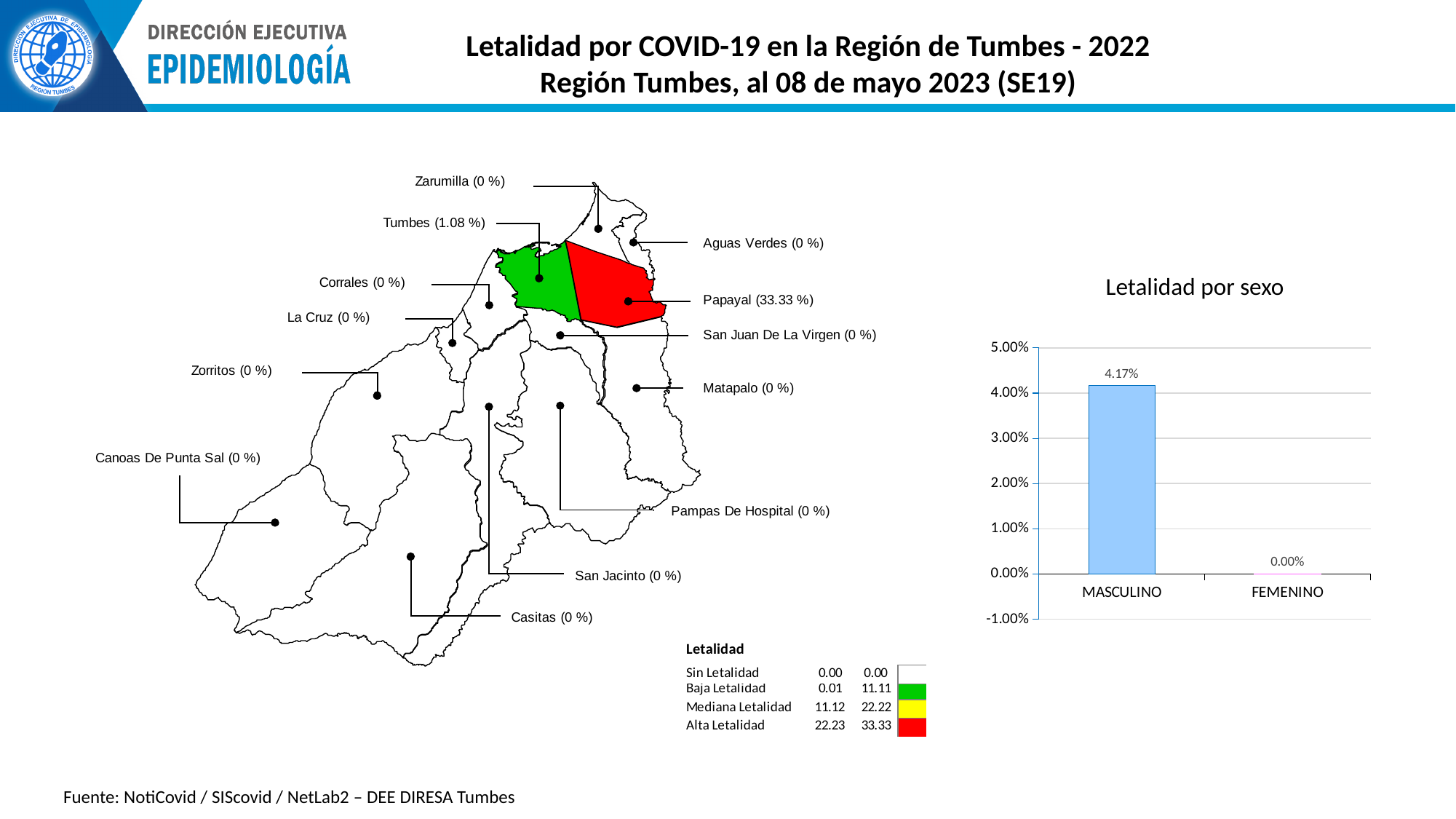
In the 'Letalidad por sexo' chart, what is the difference between the MASCULINO and FEMENINO values? 4.17% On the map of the Tumbes region, what is the lethality value shown for Tumbes? 1.08 % In the 'Letalidad por sexo' chart, which category has the lowest value? FEMENINO In the 'Letalidad por sexo' chart, what is the value for MASCULINO? 4.17% In the 'Letalidad por sexo' chart, which category has the highest value? MASCULINO What is the title of the chart on the right side of the slide? Letalidad por sexo In the 'Letalidad por sexo' chart, is the value for MASCULINO greater or less than 4.00%? greater On the map of the Tumbes region, which district has the highest lethality value? Papayal What kind of chart is 'Letalidad por sexo'? bar chart On the map of the Tumbes region, what is the lethality value shown for Papayal? 33.33 % In the 'Letalidad por sexo' chart, what is the value for FEMENINO? 0.00% How many categories are shown on the x axis of the 'Letalidad por sexo' chart? 2